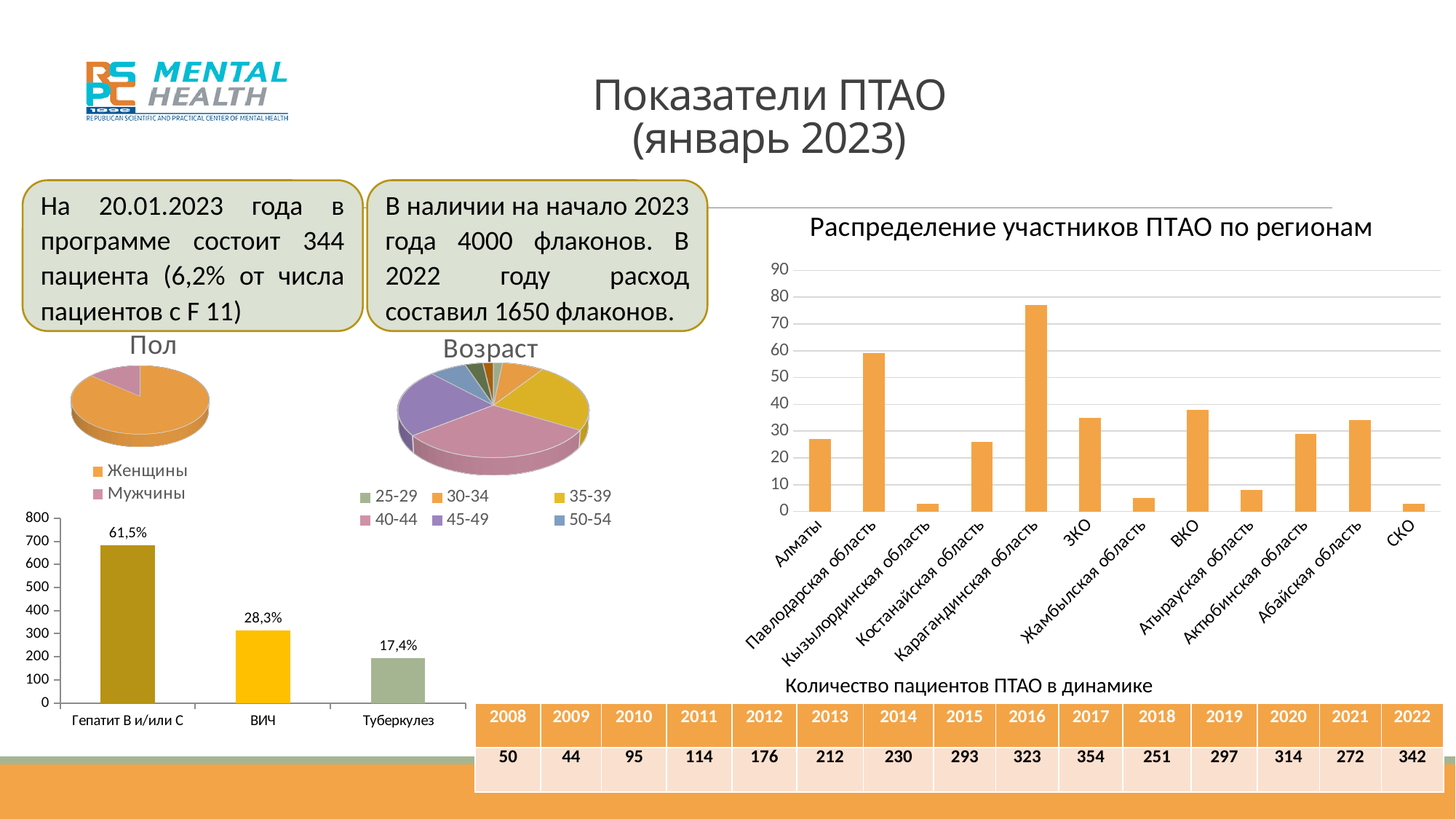
In the bar chart at the bottom left, what is the data label for Гепатит В и/или С? 61,5% In the chart 'Распределение участников ПТАО по регионам', which region has the highest value? Карагандинская область In the bar chart at the bottom left, what is the data label for ВИЧ? 28,3% In the chart 'Распределение участников ПТАО по регионам', which is larger: the value for Павлодарская область or the value for ВКО? Павлодарская область What kind of chart is 'Распределение участников ПТАО по регионам'? bar chart In the chart 'Распределение участников ПТАО по регионам', is the value for Павлодарская область greater or less than 50? greater In the bar chart at the bottom left, what is the difference between the labels for Гепатит В и/или С and ВИЧ? 33,2% In the bar chart at the bottom left, which category has the lowest value? Туберкулез In the pie chart 'Пол', which slice is larger: Женщины or Мужчины? Женщины How many entries does the legend of the pie chart 'Возраст' list? 6 How many regions are shown in the chart 'Распределение участников ПТАО по регионам'? 12 In the chart 'Распределение участников ПТАО по регионам', is the value for Алматы greater or less than 30? less